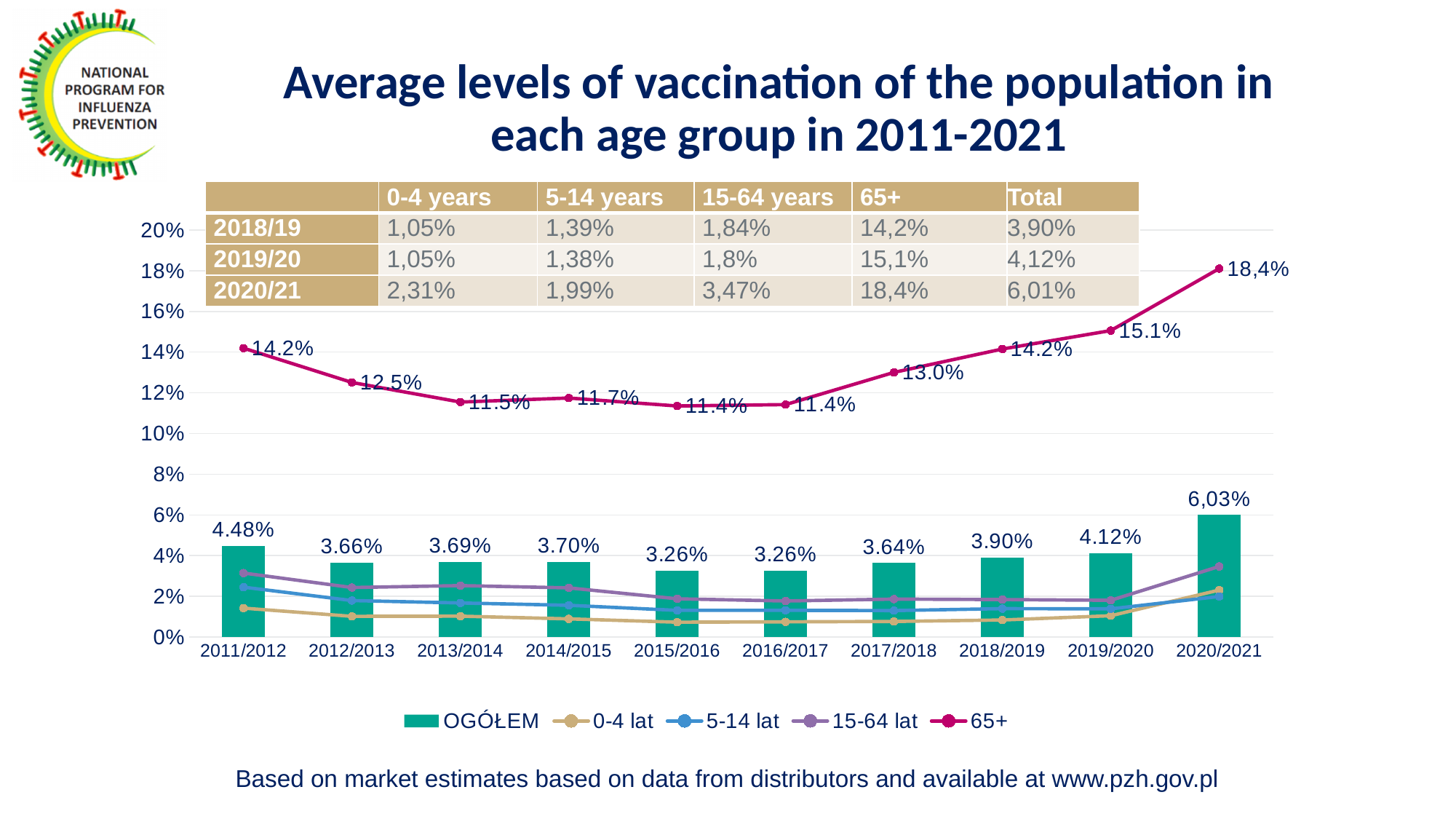
What kind of chart is this? Combined bar and line chart What is the difference between the 65+ values for 2020/2021 and 2019/2020? 3.3 percentage points How many seasons are shown on the x axis? 10 In which season does the 65+ line reach its highest value? 2020/2021 In which season is the OGÓŁEM bar highest? 2020/2021 What is the 65+ value for 2017/2018? 13.0% What is the OGÓŁEM value for 2011/2012? 4.48% Is the value for 15-64 lat in 2020/2021 greater or less than 2%? greater What is the 65+ value for 2020/2021? 18,4% Does the 65+ line rise or fall from 2016/2017 to 2020/2021? rise How many series does the legend list? 5 Which is larger, the 65+ value for 2011/2012 or for 2012/2013? 2011/2012